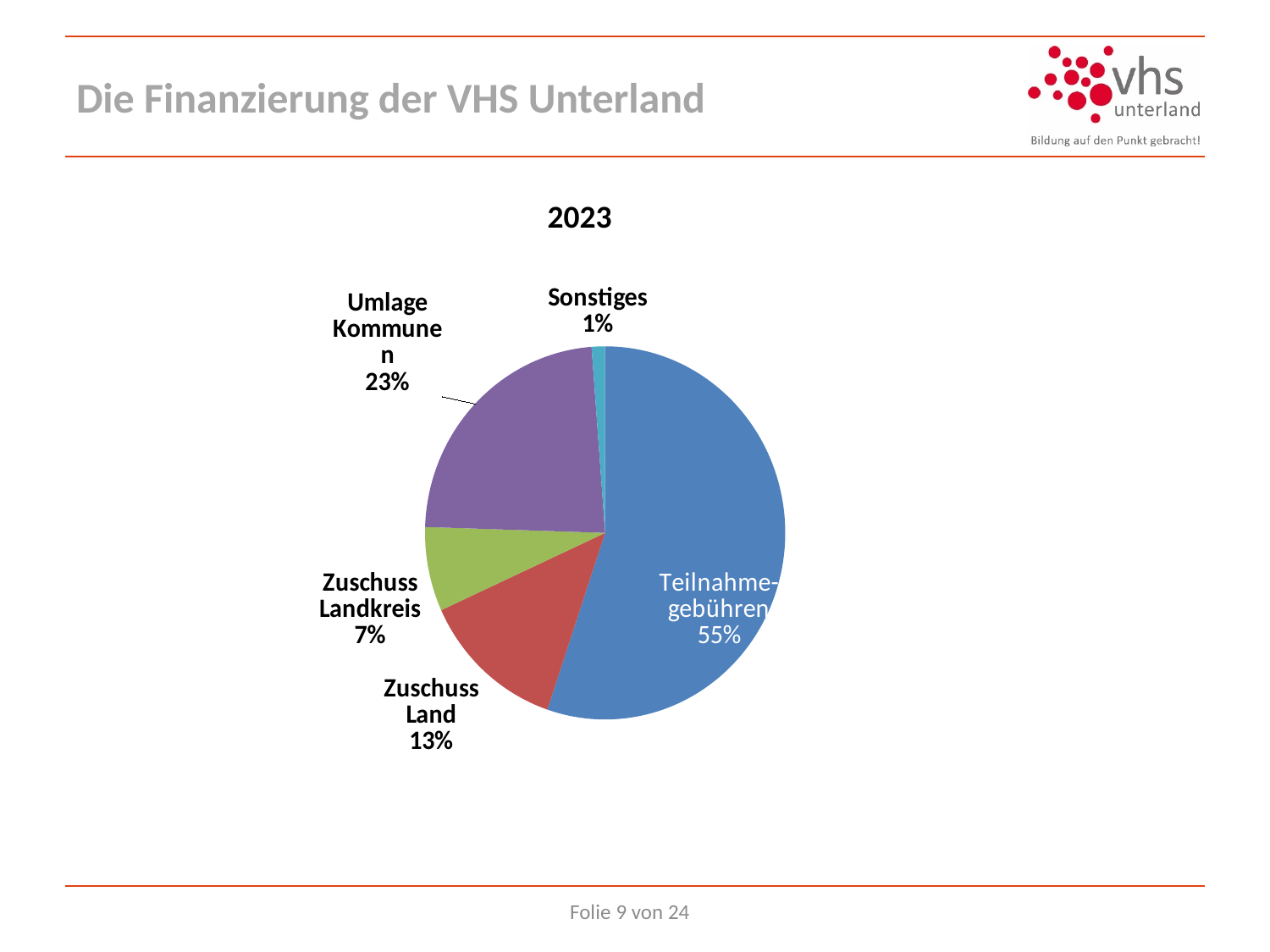
Which category has the smallest share of the pie? Sonstiges What share of the pie is Umlage Kommunen? 23% Which category has the largest share of the pie? Teilnahmegebühren What is the value for Zuschuss Landkreis? 7% What is the value for Zuschuss Land? 13% What is the difference between the shares of Teilnahmegebühren and Umlage Kommunen? 32 percentage points What share of the pie is Teilnahmegebühren? 55% Which is larger, Zuschuss Land or Zuschuss Landkreis? Zuschuss Land How many slices does the pie chart have? 5 What kind of chart is shown on the slide? pie chart What is the value for Sonstiges? 1% What is the title of the chart? 2023